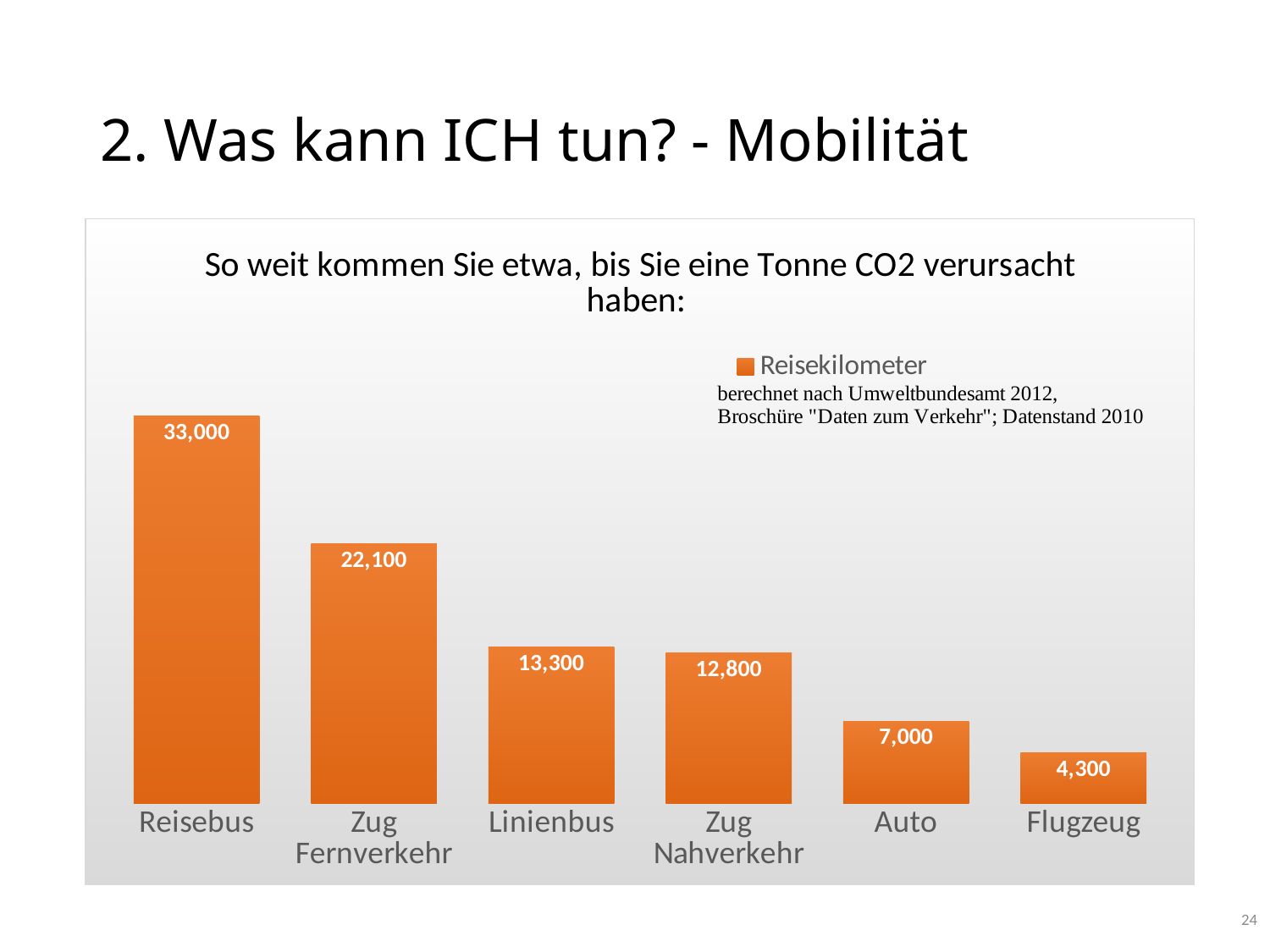
What kind of chart is shown on the slide? Bar chart What is the value for Flugzeug? 4,300 How many categories are shown in the chart? 6 What series name does the legend show? Reisekilometer What is the difference between the values for Reisebus and Zug Fernverkehr? 10,900 What is the difference between the values for Linienbus and Zug Nahverkehr? 500 Which is larger, the value for Auto or the value for Flugzeug? Auto What is the value for Zug Fernverkehr? 22,100 What is the value for Reisebus? 33,000 What is the value for Auto? 7,000 Which category has the lowest value? Flugzeug Which category has the highest value? Reisebus